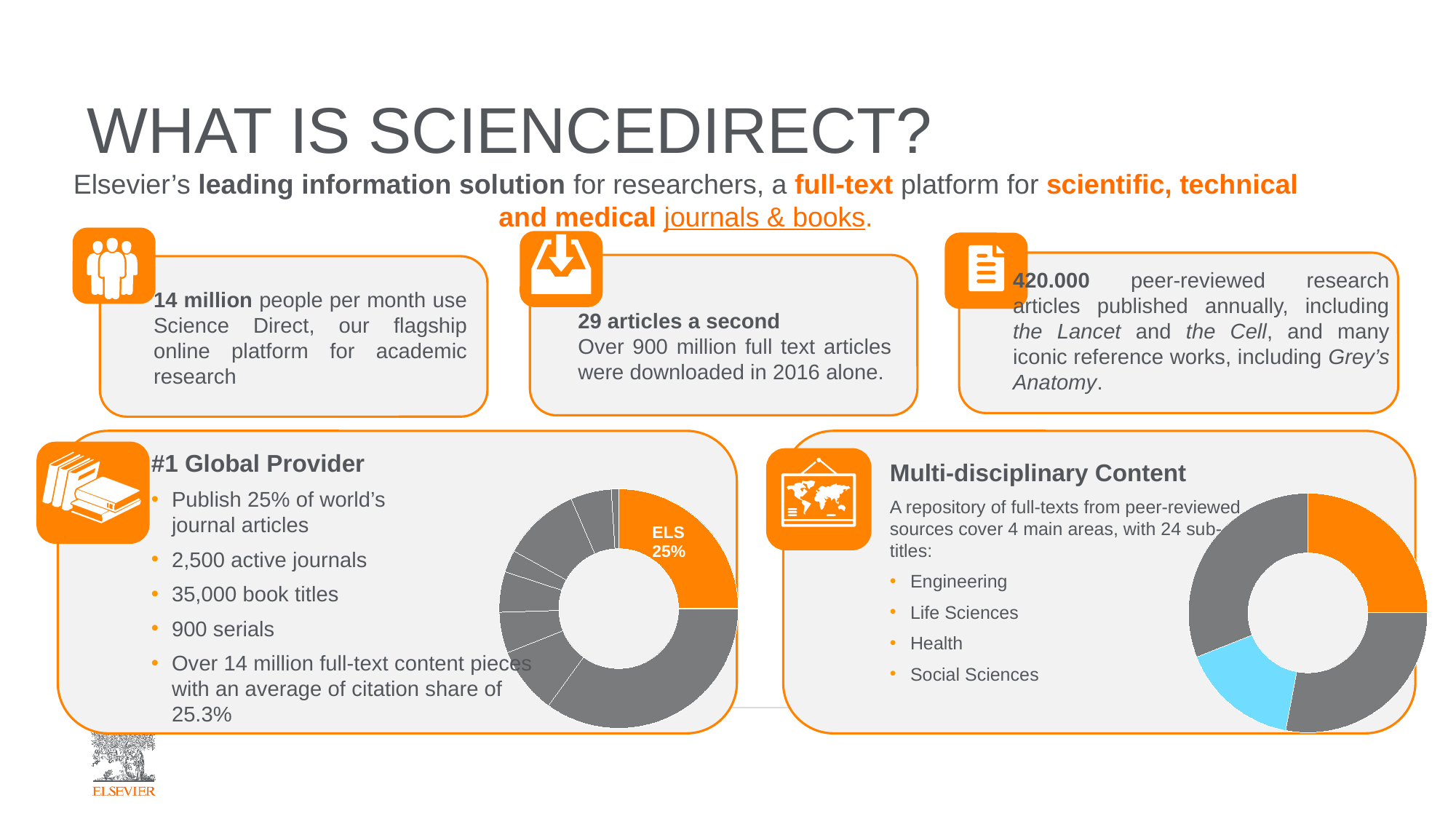
What kind of chart is shown in the '#1 Global Provider' box? Pie (donut) chart In the donut chart in the 'Multi-disciplinary Content' box, is the orange slice larger or smaller than the light blue slice? Larger In the donut chart in the 'Multi-disciplinary Content' box, which coloured slice is the smallest? The light blue slice In the donut chart in the '#1 Global Provider' box, what colour is the ELS slice? Orange In the donut chart in the '#1 Global Provider' box, which slice is labelled with a name and value? ELS In the donut chart in the '#1 Global Provider' box, what value is shown for ELS? 25% How many slices does the donut chart in the 'Multi-disciplinary Content' box have? 4 What kind of chart is shown in the 'Multi-disciplinary Content' box? Pie (donut) chart